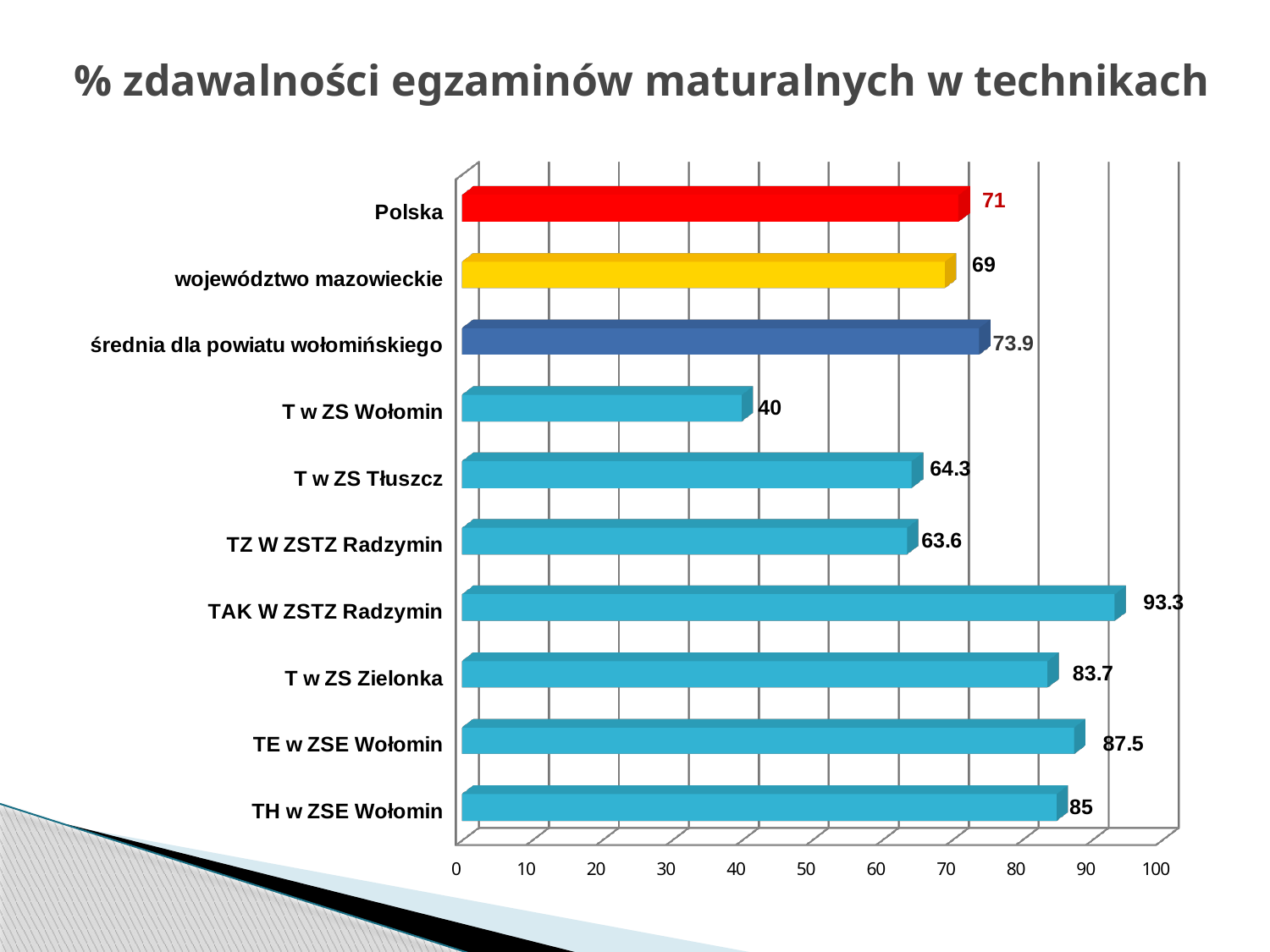
What is the value for Polska? 71 What kind of chart is shown on the slide? bar chart What colour is the bar for Polska? red What is the value for średnia dla powiatu wołomińskiego? 73.9 What is the difference between the values for TE w ZSE Wołomin and TH w ZSE Wołomin? 2.5 Which category has the highest value? TAK W ZSTZ Radzymin What is the title of the chart? % zdawalności egzaminów maturalnych w technikach Which category has the lowest value? T w ZS Wołomin Which is larger, the value for Polska or the value for województwo mazowieckie? Polska What is the value for TAK W ZSTZ Radzymin? 93.3 What is the value for T w ZS Wołomin? 40 How many categories are shown in the chart? 10